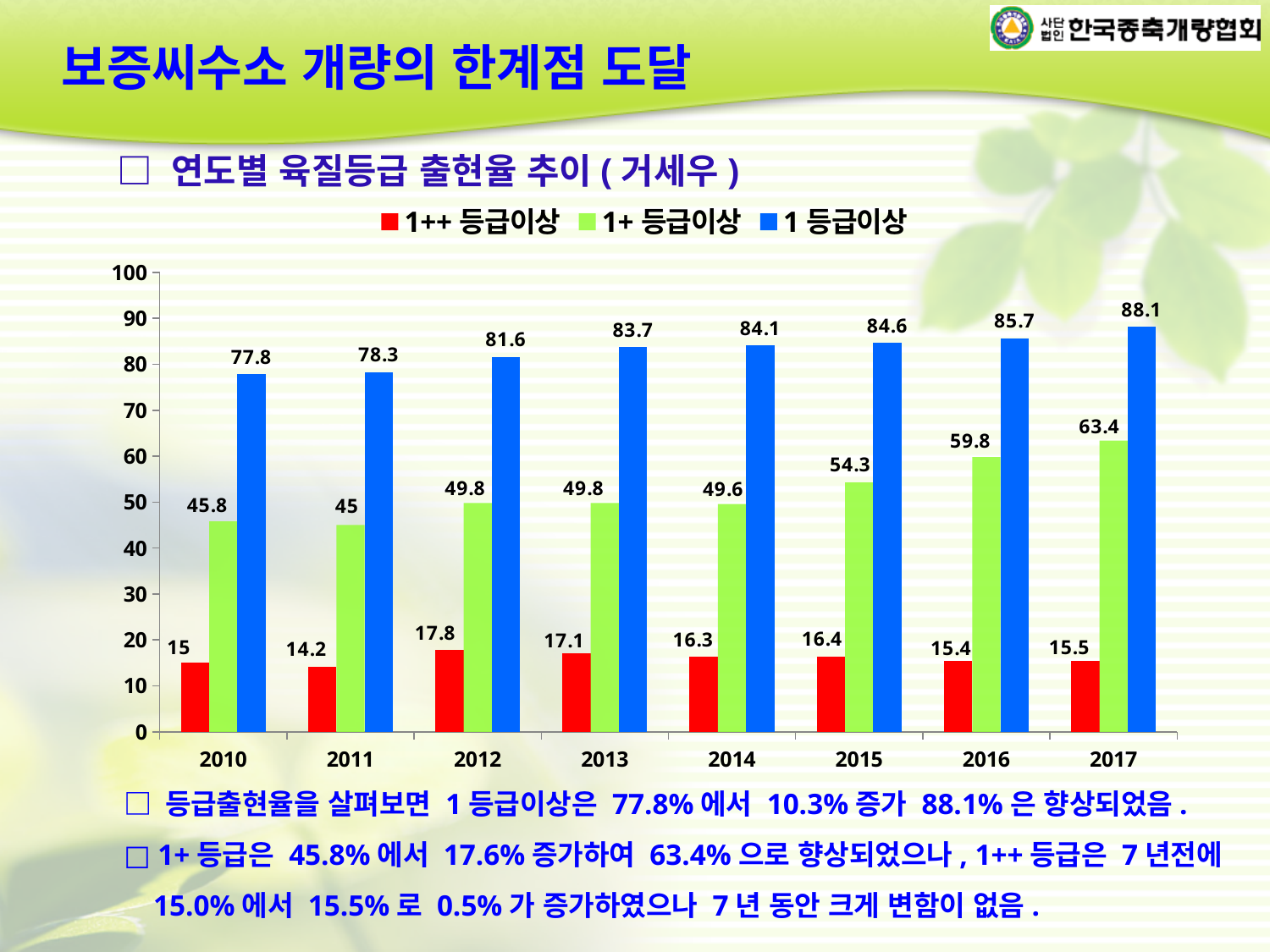
What is the value for 1+ 등급이상 in 2015? 54.3 In which year is the 1+ 등급이상 value the highest? 2017 What kind of chart is shown on the slide? bar chart What is the value for 1 등급이상 in 2017? 88.1 What is the difference between the 1 등급이상 values in 2017 and 2010? 10.3 How many years are shown on the x axis? 8 Does the 1 등급이상 series rise or fall from 2010 to 2017? rise How many series does the legend list? 3 Which is larger, the 1++ 등급이상 value in 2013 or in 2014? 2013 What is the value for 1++ 등급이상 in 2012? 17.8 What is the difference between the 1+ 등급이상 values in 2017 and 2016? 3.6 In which year is the 1++ 등급이상 value the lowest? 2011